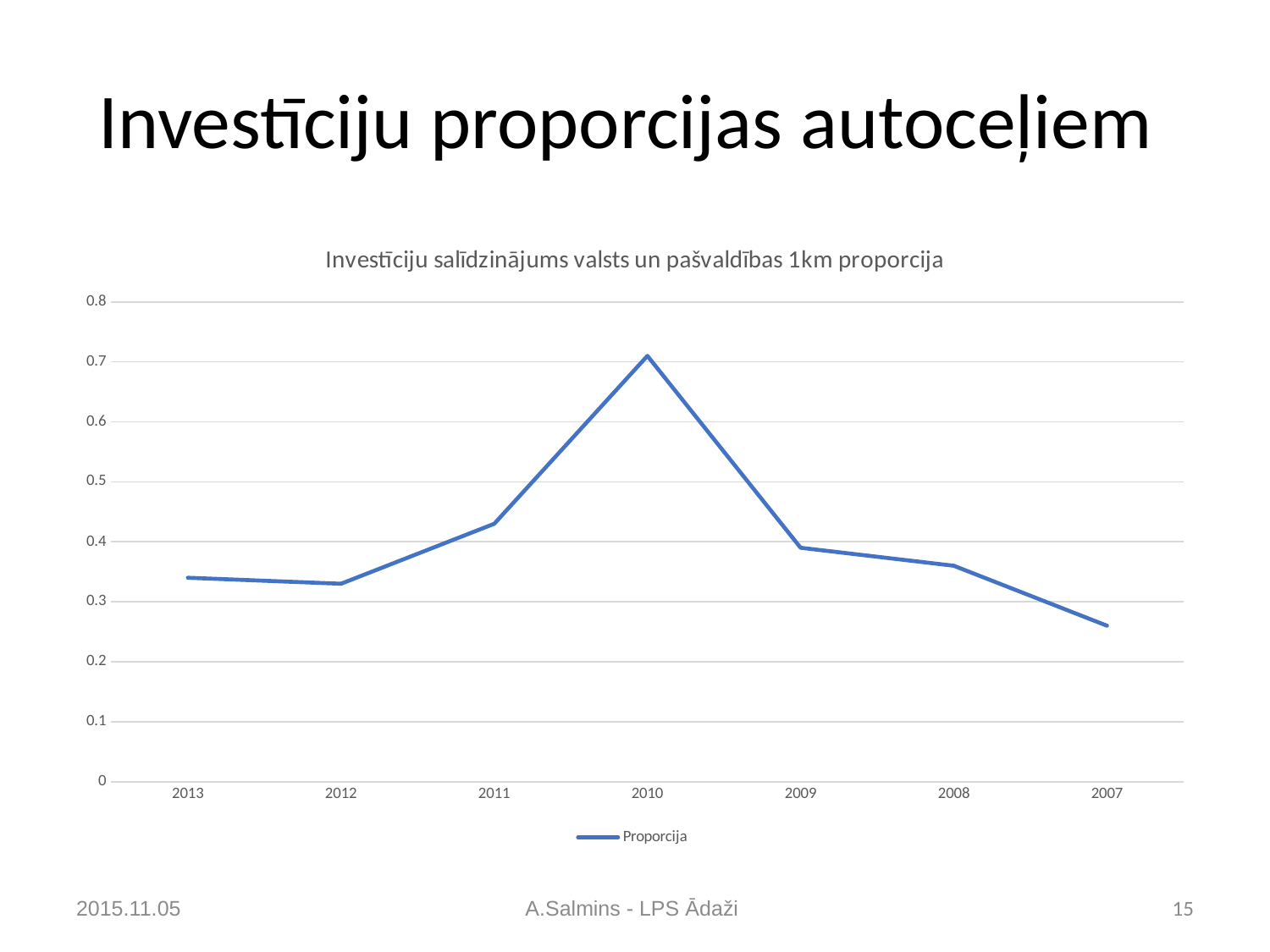
Is the value for 2011 greater or less than 0.4? greater What kind of chart is shown on the slide? line chart Is the value for 2007 greater or less than 0.3? less Which year has the highest value in the chart? 2010 Which year has the lowest value in the chart? 2007 What is the title of the chart? Investīciju salīdzinājums valsts un pašvaldības 1km proporcija Is the value for 2008 greater or less than 0.4? less How many years are plotted on the x axis? 7 How many series does the legend list? 1 Which year has the larger value, 2010 or 2013? 2010 Which year has the larger value, 2011 or 2009? 2011